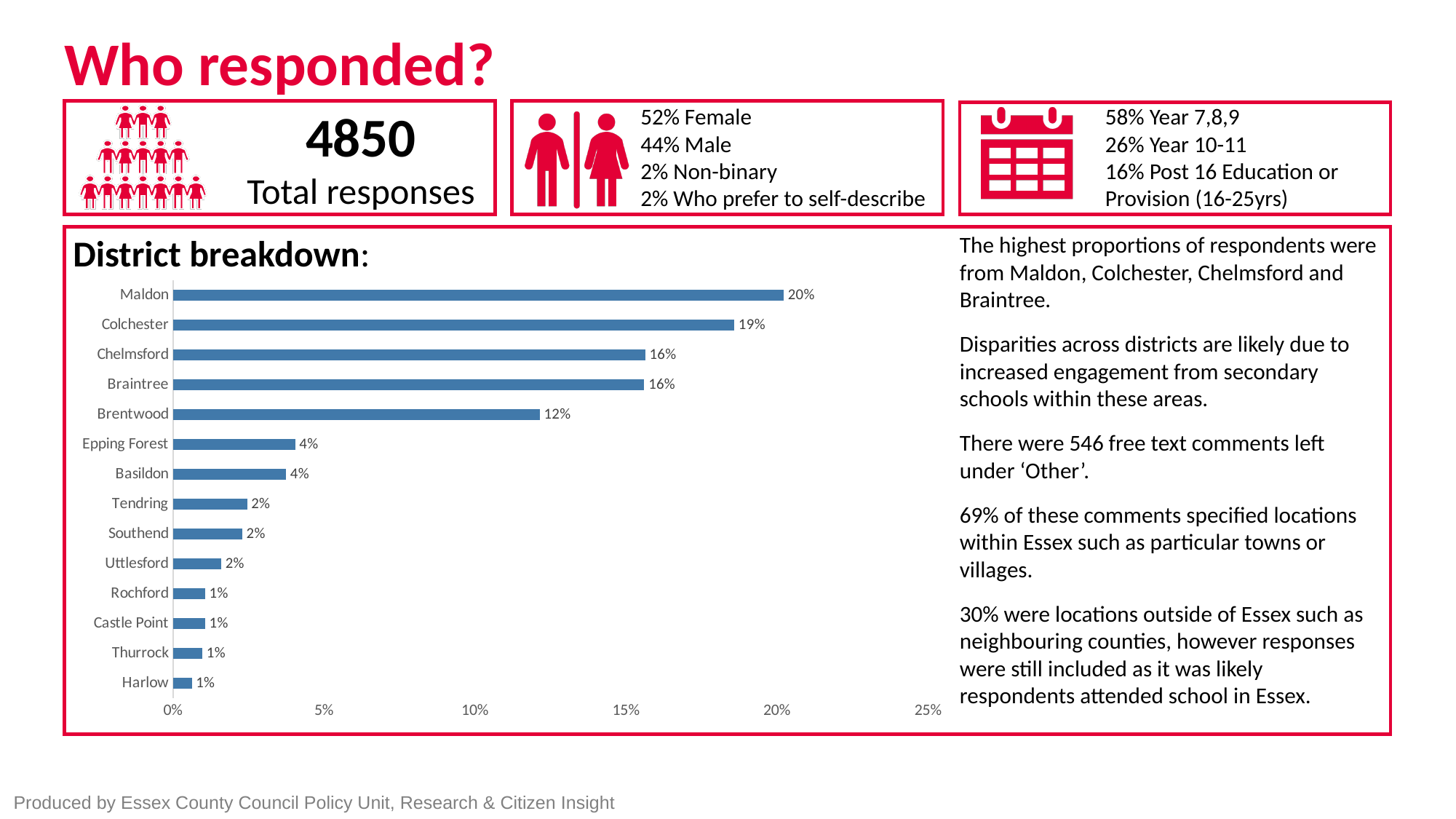
Is the value for Brentwood in the District breakdown chart greater or less than 10%? greater Which district has the highest proportion of respondents in the District breakdown chart? Maldon What is the value shown for Brentwood in the District breakdown chart? 12% What percentage of respondents were from Maldon in the District breakdown chart? 20% Which has a larger value in the District breakdown chart, Colchester or Brentwood? Colchester What is the difference between the values for Colchester and Chelmsford in the District breakdown chart? 3% What type of chart is the District breakdown chart? Bar chart What percentage is shown for Epping Forest in the District breakdown chart? 4% What is the title of the chart on the slide? District breakdown Is the value for Basildon in the District breakdown chart greater or less than 5%? less What is the difference between the values for Maldon and Brentwood in the District breakdown chart? 8% How many districts are shown in the District breakdown chart? 14